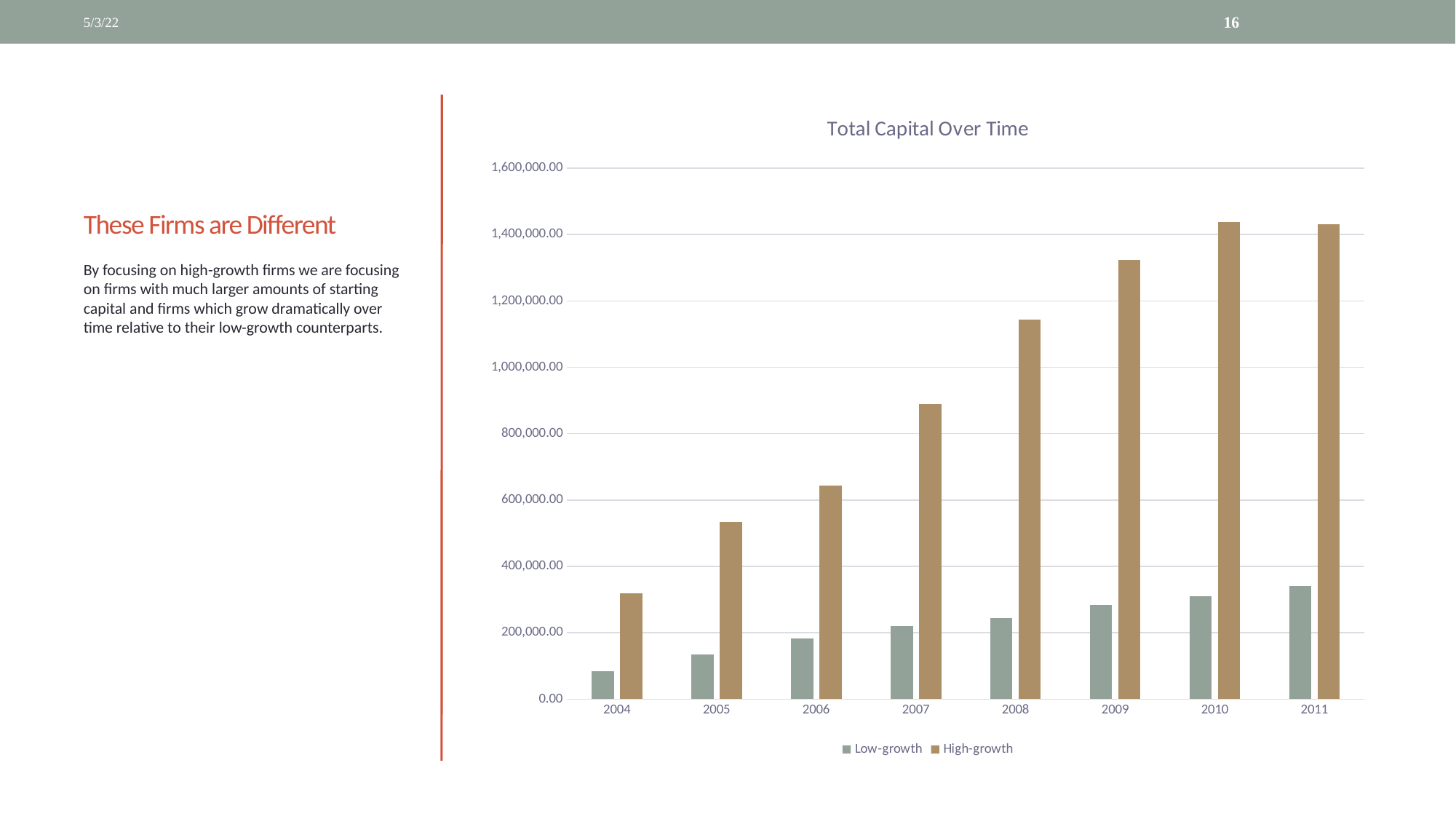
Is the High-growth value for 2008 greater or less than 1,000,000.00? greater Which year has the lowest High-growth value? 2004 How many years are shown on the x axis? 8 Which year has the lowest Low-growth value? 2004 Which year has the highest Low-growth value? 2011 Is the Low-growth value for 2011 greater or less than 400,000.00? less How many series does the legend list? 2 Is the High-growth value for 2007 greater or less than 800,000.00? greater What type of chart is shown on the slide? Bar chart What is the title of the chart? Total Capital Over Time Which is larger in 2006, the Low-growth value or the High-growth value? High-growth Do the Low-growth values rise or fall from 2004 to 2011? Rise